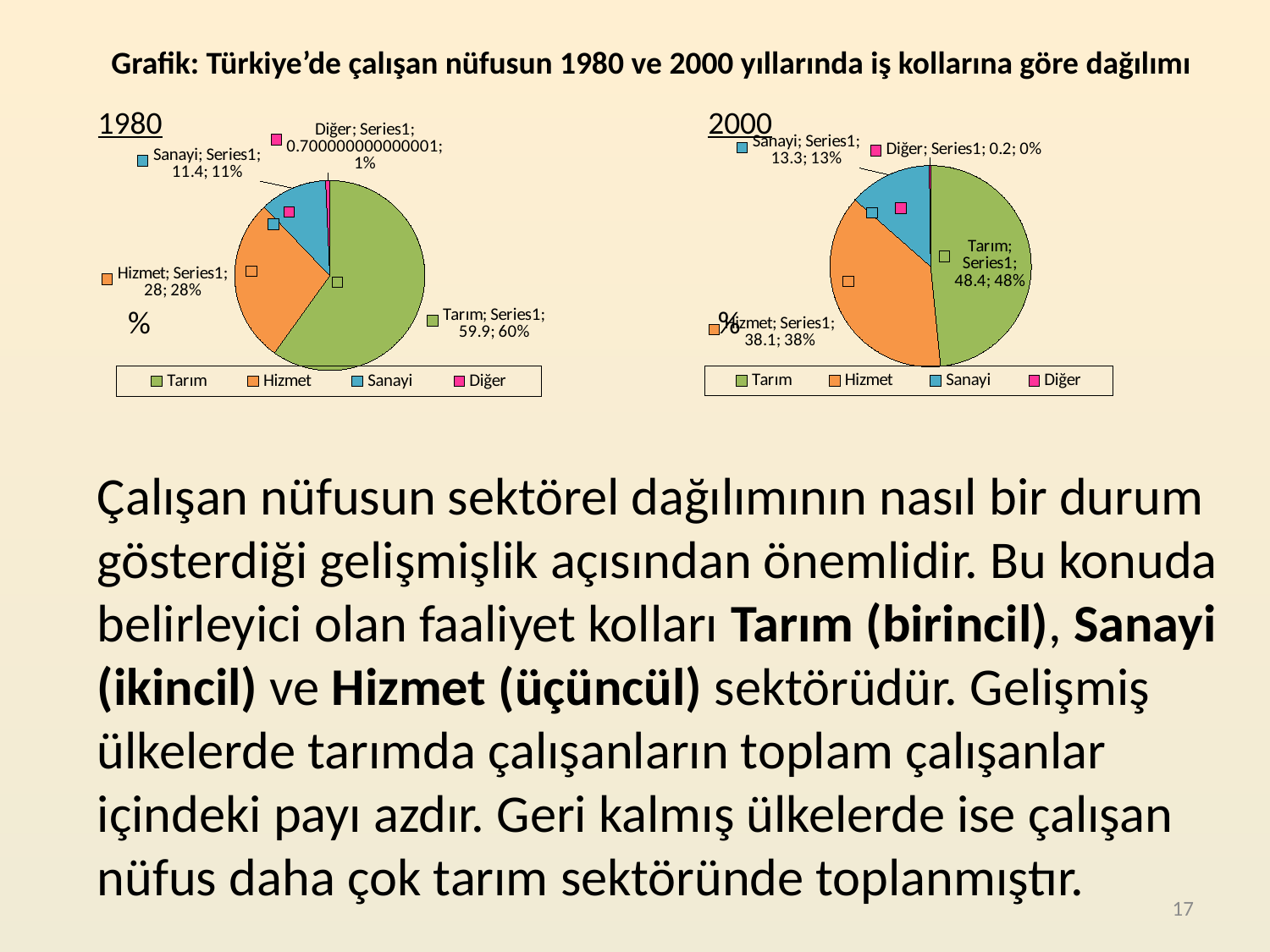
In the 1980 pie chart, what value is shown for Sanayi? 11.4 In the 2000 pie chart, which category has the smallest slice? Diğer What is the difference between the Tarım value in the 1980 chart and the Tarım value in the 2000 chart? 11.5 In the 2000 pie chart, what value is shown for Tarım? 48.4 In the 2000 pie chart, what value is shown for Diğer? 0.2 How many categories does the legend of the 2000 pie chart list? 4 In the 1980 pie chart, which category has the largest slice? Tarım In the 1980 pie chart, what percentage share is shown for Hizmet? 28% In the 2000 pie chart, what value is shown for Hizmet? 38.1 In the 2000 pie chart, what percentage share is shown for Sanayi? 13% What type of chart is used for the 1980 data on the slide? pie chart In the 1980 pie chart, what value is shown for Tarım? 59.9